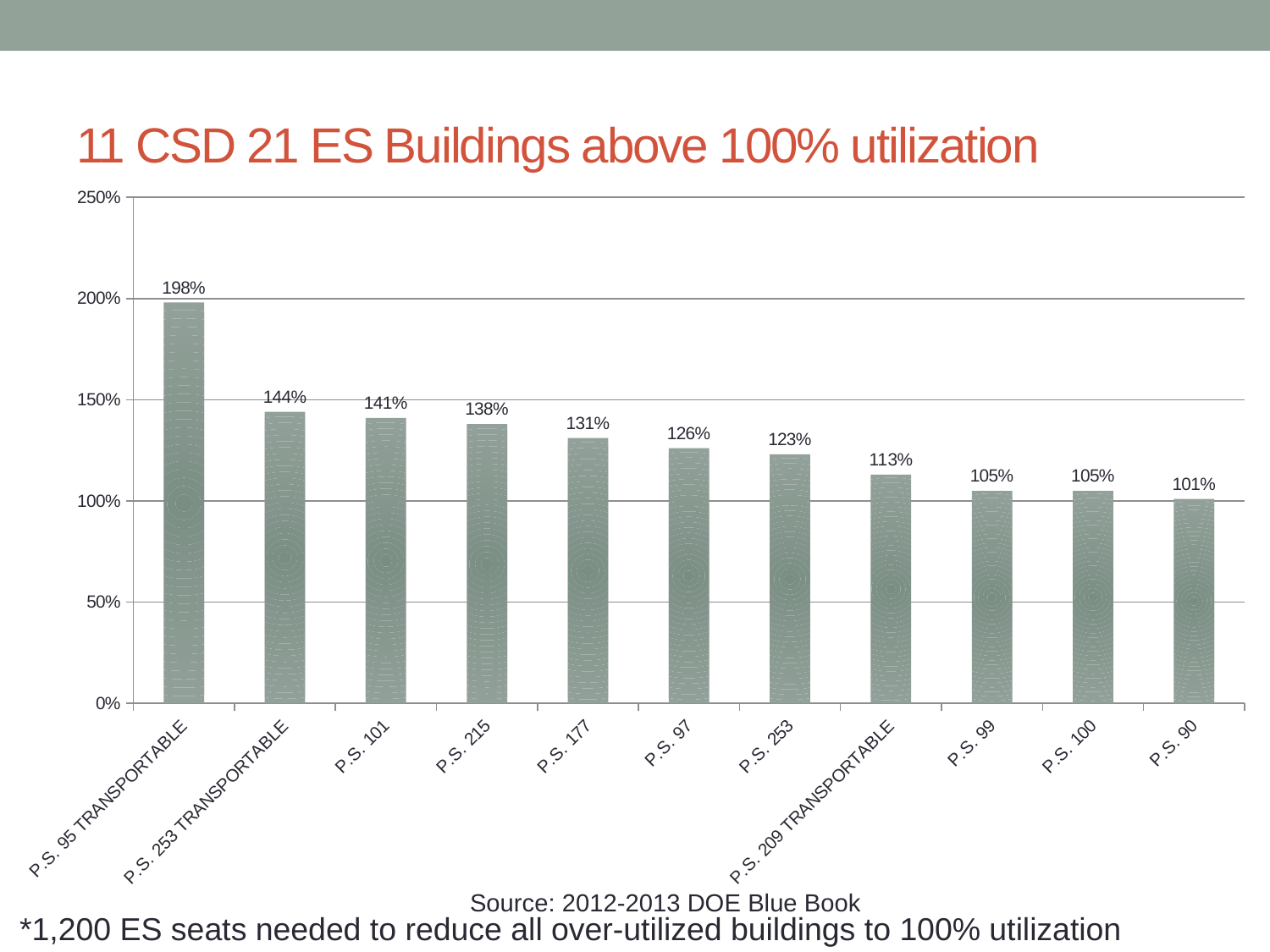
Is the value for P.S. 95 TRANSPORTABLE greater or less than 150%? greater Which building has the lowest utilization? P.S. 90 Which has a higher utilization, P.S. 177 or P.S. 99? P.S. 177 What is the utilization value for P.S. 97? 126% What is the difference in utilization between P.S. 95 TRANSPORTABLE and P.S. 253 TRANSPORTABLE? 54% What is the title of the chart? 11 CSD 21 ES Buildings above 100% utilization How many buildings are shown in the chart? 11 What kind of chart is shown on the slide? Bar chart What is the difference in utilization between P.S. 215 and P.S. 253? 15% Which building has the highest utilization? P.S. 95 TRANSPORTABLE What is the utilization value for P.S. 209 TRANSPORTABLE? 113% What is the utilization value for P.S. 101? 141%